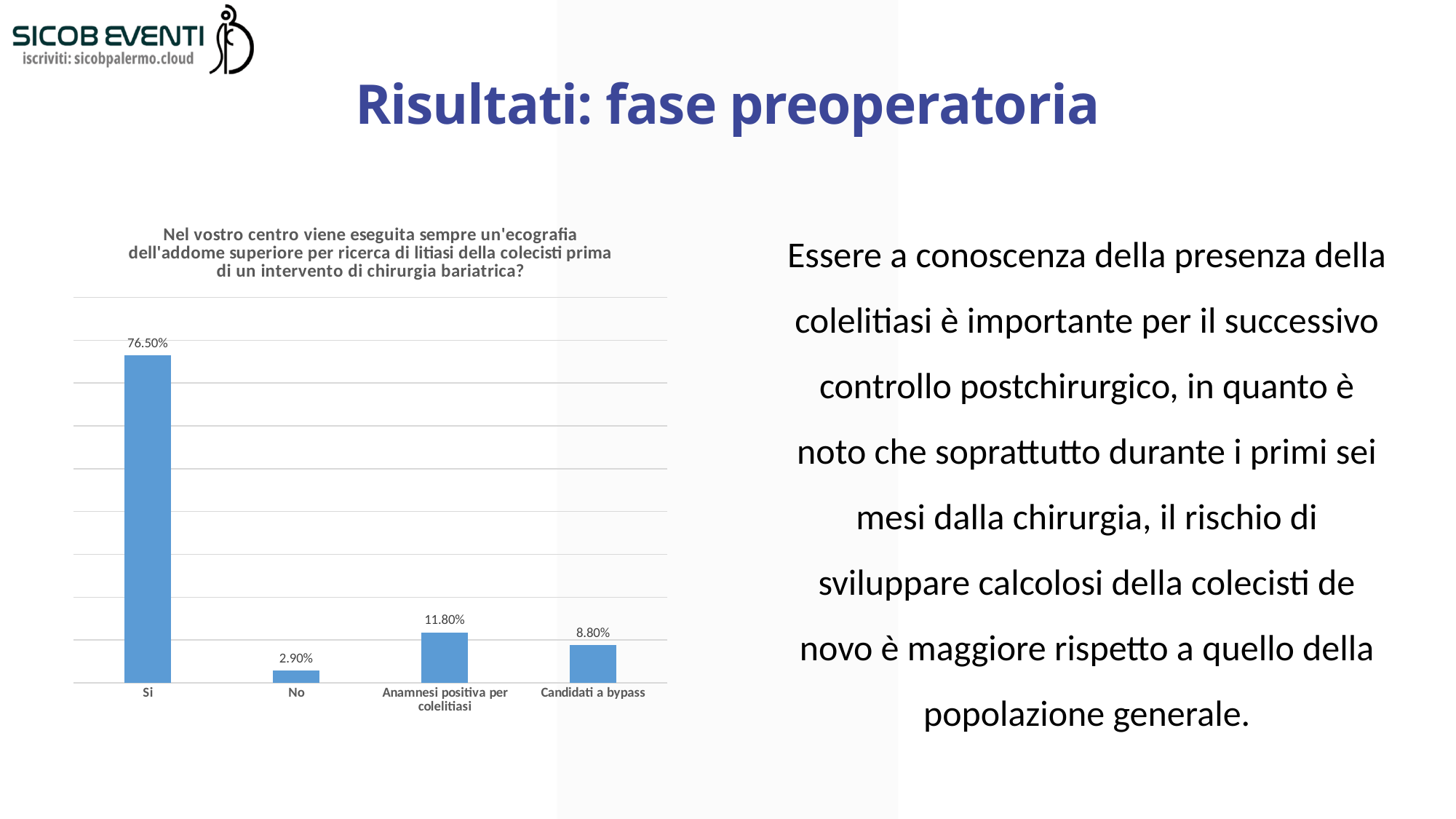
What colour are the bars in the chart? Blue What is the value for "No"? 2.90% What is the value for "Candidati a bypass"? 8.80% Which category has the highest value? Si How many categories are shown on the x axis of the chart? 4 What is the value for "Anamnesi positiva per colelitiasi"? 11.80% What is the difference between the values for "Anamnesi positiva per colelitiasi" and "Candidati a bypass"? 3.00% Which is larger, the value for "Anamnesi positiva per colelitiasi" or the value for "Candidati a bypass"? Anamnesi positiva per colelitiasi What is the value for "Si"? 76.50% What kind of chart is shown on the slide? Bar chart Which category has the lowest value? No What is the difference between the values for "Si" and "No"? 73.60%